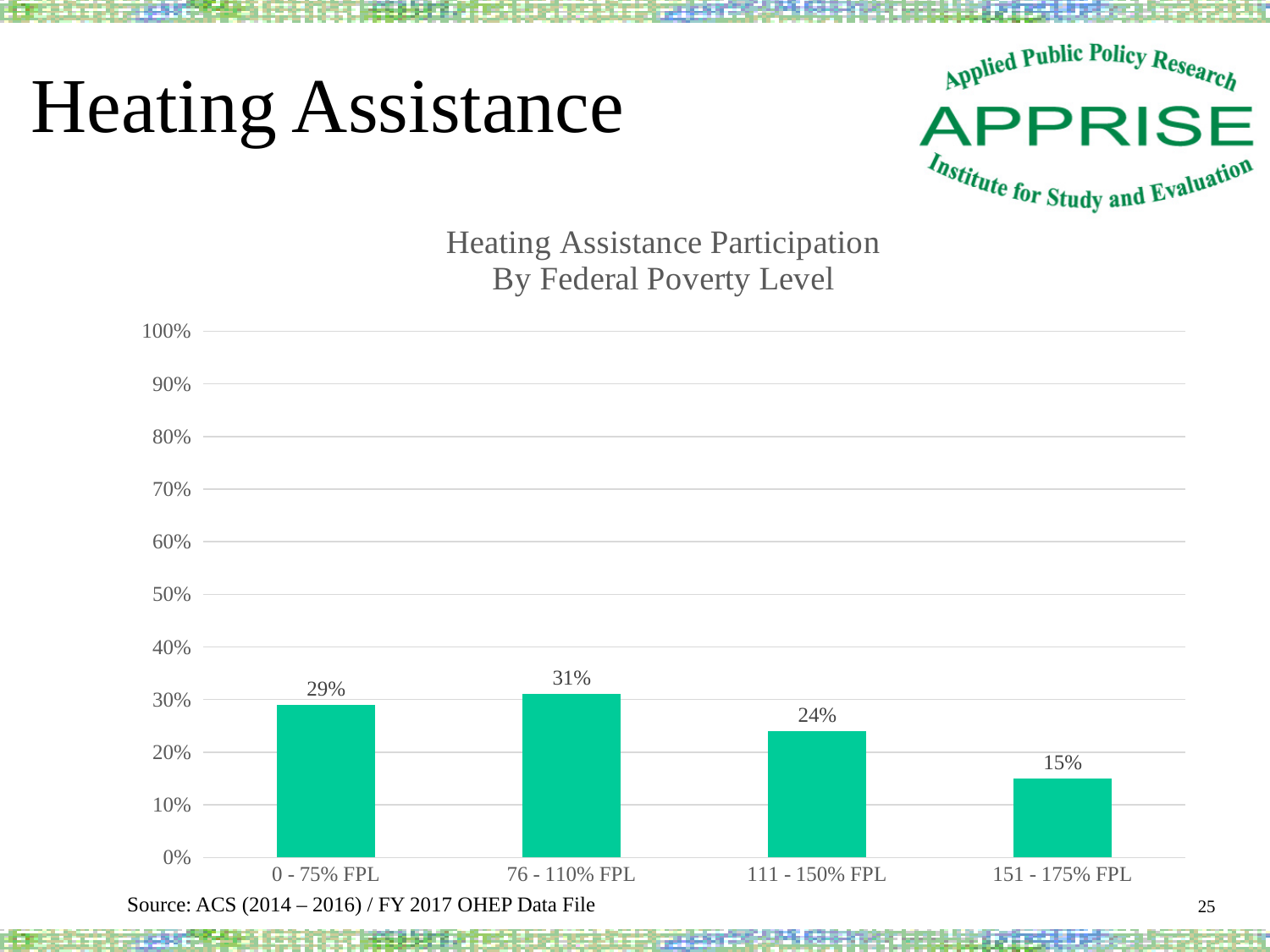
How many federal poverty level groups are shown in the chart? 4 What is the difference in participation rate between the 0 - 75% FPL group and the 111 - 150% FPL group? 5% What is the heating assistance participation rate for the 0 - 75% FPL group? 29% What is the heating assistance participation rate for the 111 - 150% FPL group? 24% What is the heating assistance participation rate for the 151 - 175% FPL group? 15% What is the difference in participation rate between the 76 - 110% FPL group and the 151 - 175% FPL group? 16% Which federal poverty level group has the highest participation rate? 76 - 110% FPL What is the title of the chart? Heating Assistance Participation By Federal Poverty Level What type of chart is used to show heating assistance participation by federal poverty level? Bar chart What is the heating assistance participation rate for the 76 - 110% FPL group? 31% Which group has a higher participation rate, 0 - 75% FPL or 111 - 150% FPL? 0 - 75% FPL Which federal poverty level group has the lowest participation rate? 151 - 175% FPL